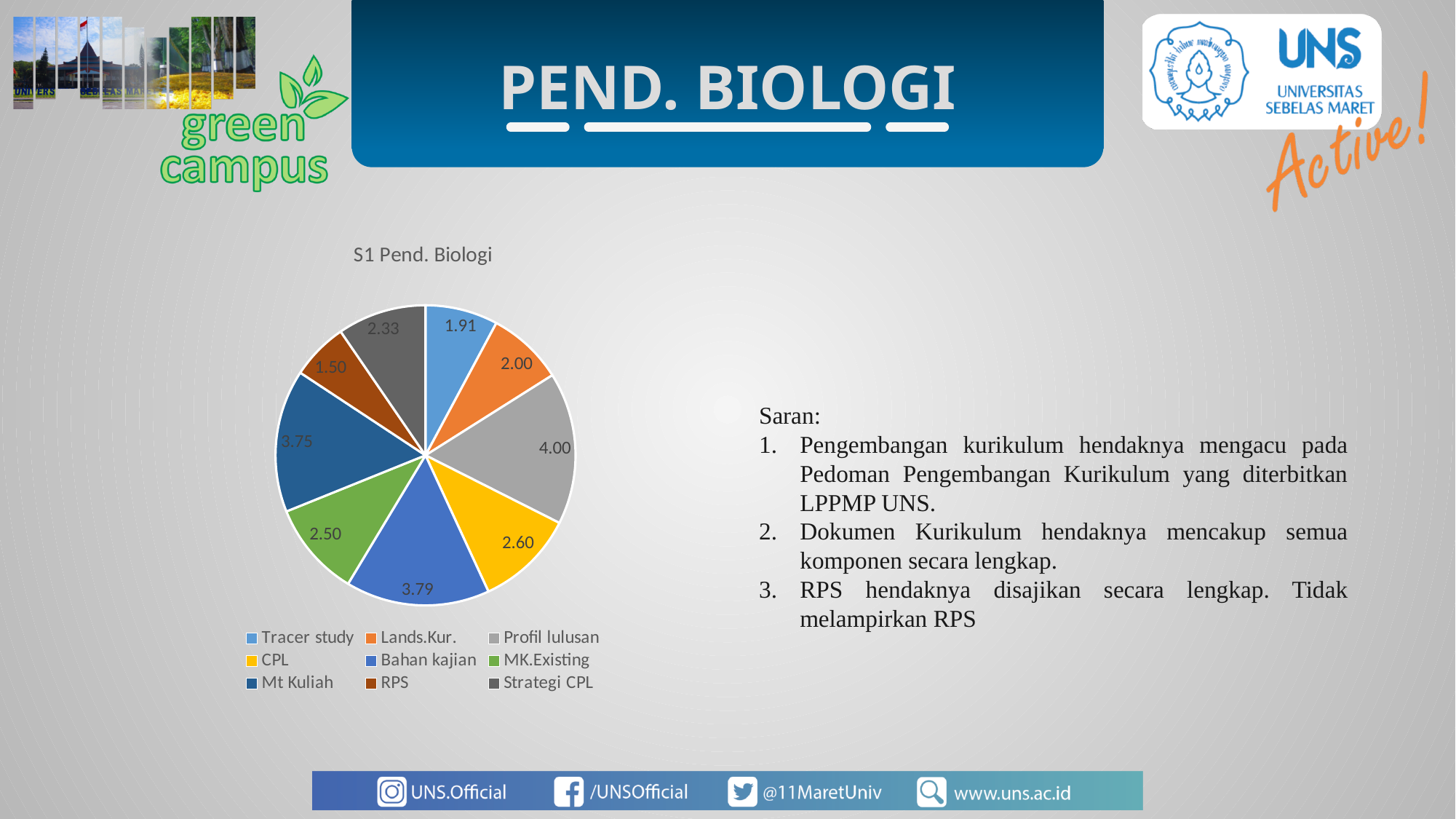
Which category has the largest slice in the pie chart? Profil lulusan What is the value for Profil lulusan in the S1 Pend. Biologi pie chart? 4.00 How many categories does the pie chart show? 9 Which category has the smallest slice in the pie chart? RPS What is the title of the chart? S1 Pend. Biologi Which is larger, the value for CPL or the value for MK.Existing? CPL What is the difference between the values for Profil lulusan and RPS? 2.50 What is the value for RPS in the pie chart? 1.50 What is the value for Bahan kajian in the pie chart? 3.79 What kind of chart is shown on the slide? Pie chart What colour is the Strategi CPL slice in the pie chart? Dark gray What is the value for Tracer study in the pie chart? 1.91